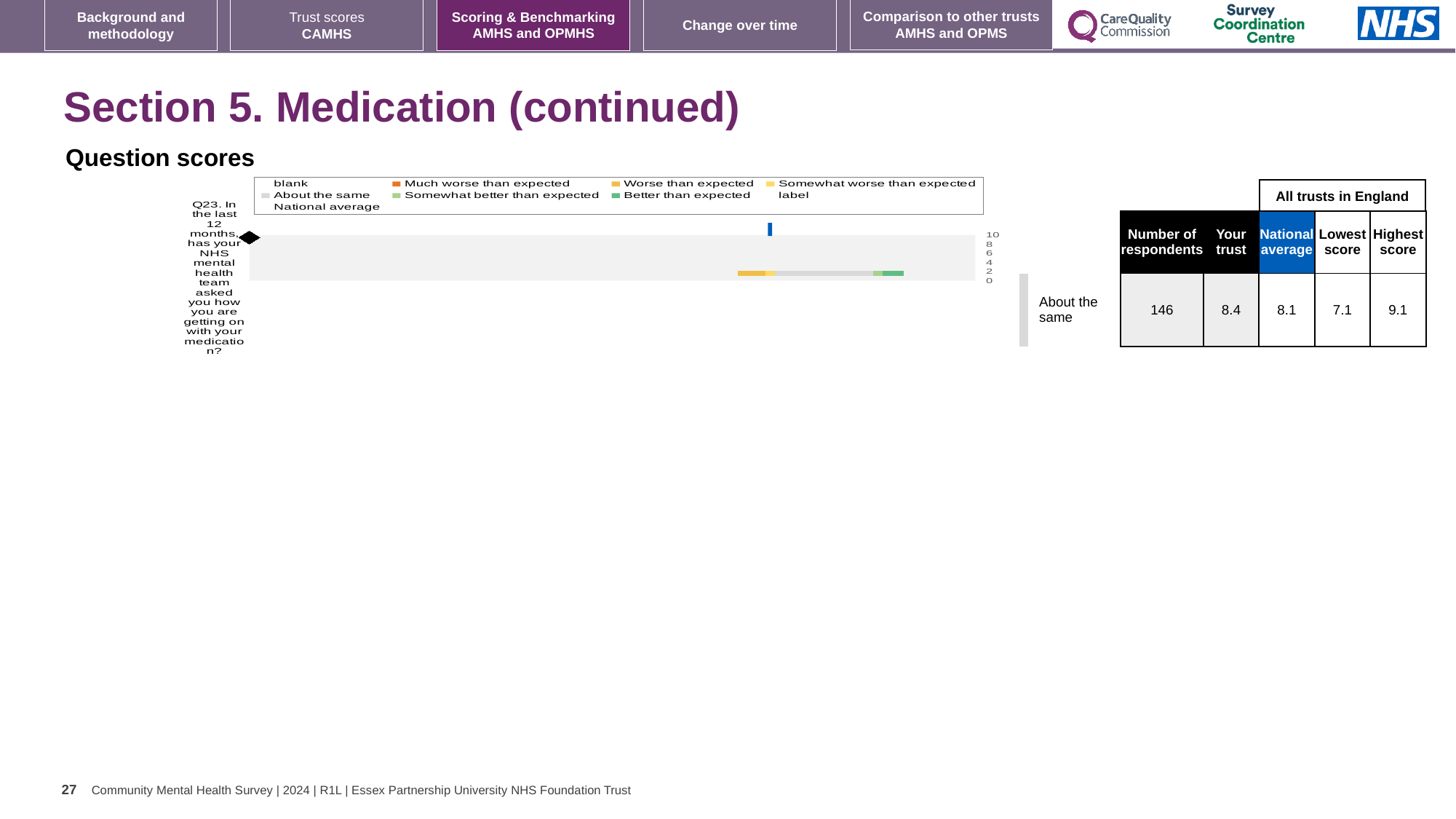
For Q23, what is the difference between the 'Your trust' score and the national average? 0.3 For Q23, which is larger: the 'Your trust' score or the national average? Your trust What is the lowest score among all trusts in England for Q23? 7.1 What is the national average score for Q23 in the table beside the chart? 8.1 What kind of chart is used to show the question scores for Q23? bar chart For Q23, what is the difference between the highest score and the lowest score among all trusts in England? 2.0 How many respondents answered Q23? 146 What is the highest value shown on the score axis of the chart? 10 How many questions are plotted in the question scores chart? 1 What is the 'Your trust' score for Q23 in the table beside the chart? 8.4 What is the highest score among all trusts in England for Q23? 9.1 Which survey question is plotted in the question scores chart? Q23. In the last 12 months, has your NHS mental health team asked you how you are getting on with your medication?